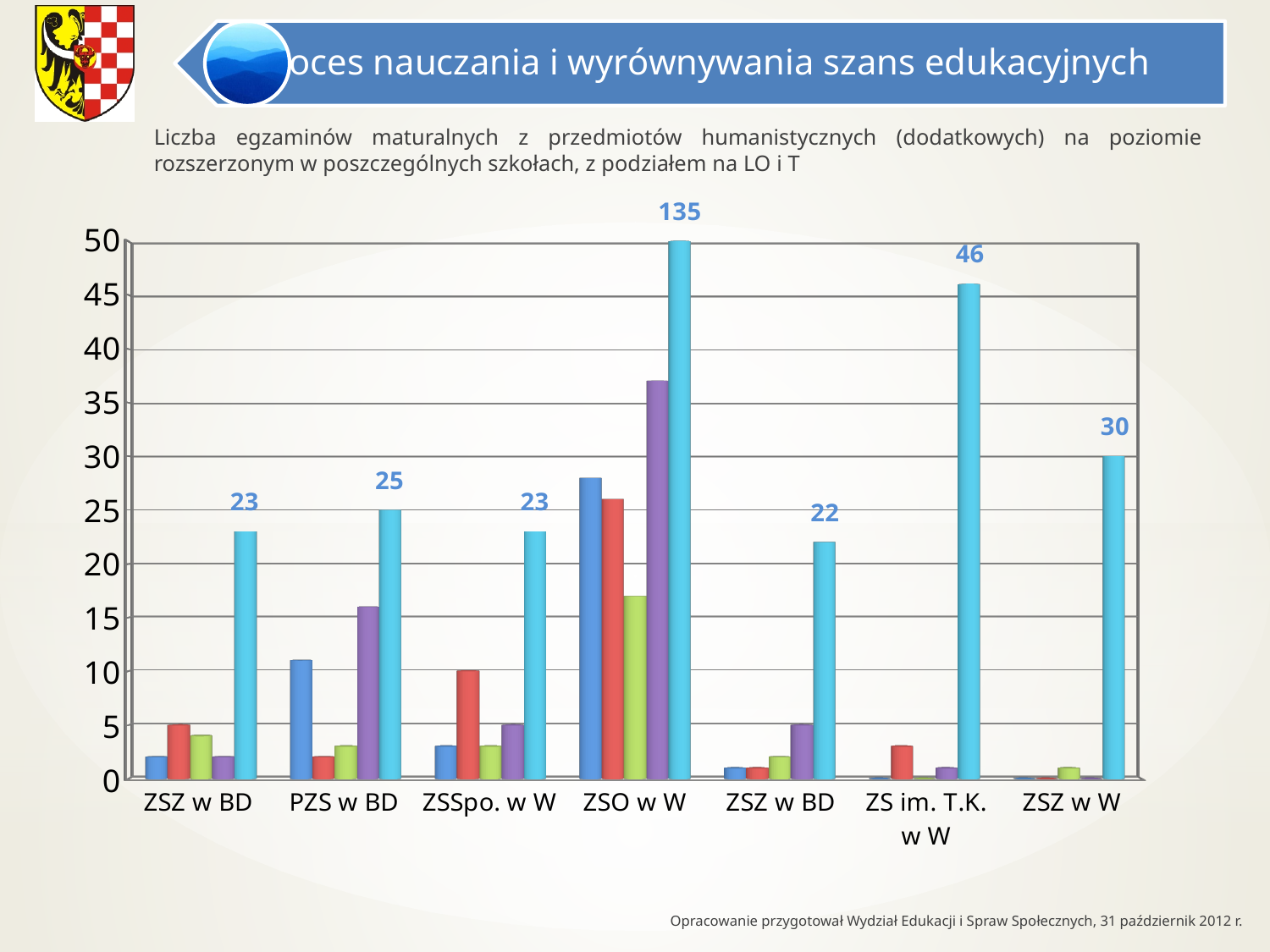
What is the difference between the labelled values for ZSO w W and ZS im. T.K. w W? 89 Which category has the highest labelled value in the chart? ZSO w W How many school categories are shown along the x axis of the chart? 7 What is the highest tick value shown on the vertical axis of the chart? 50 What is the labelled value of the light blue bar for ZSO w W? 135 Is the value of the purple bar for ZSO w W greater or less than 30? greater What is the labelled value of the light blue bar for ZSZ w W? 30 Which has the larger labelled value: PZS w BD or ZSSpo. w W? PZS w BD What is the labelled value of the light blue bar for ZS im. T.K. w W? 46 What is the difference between the labelled values for ZS im. T.K. w W and ZSZ w W? 16 What kind of chart is shown on the slide? bar chart What is the labelled value of the light blue bar for PZS w BD? 25